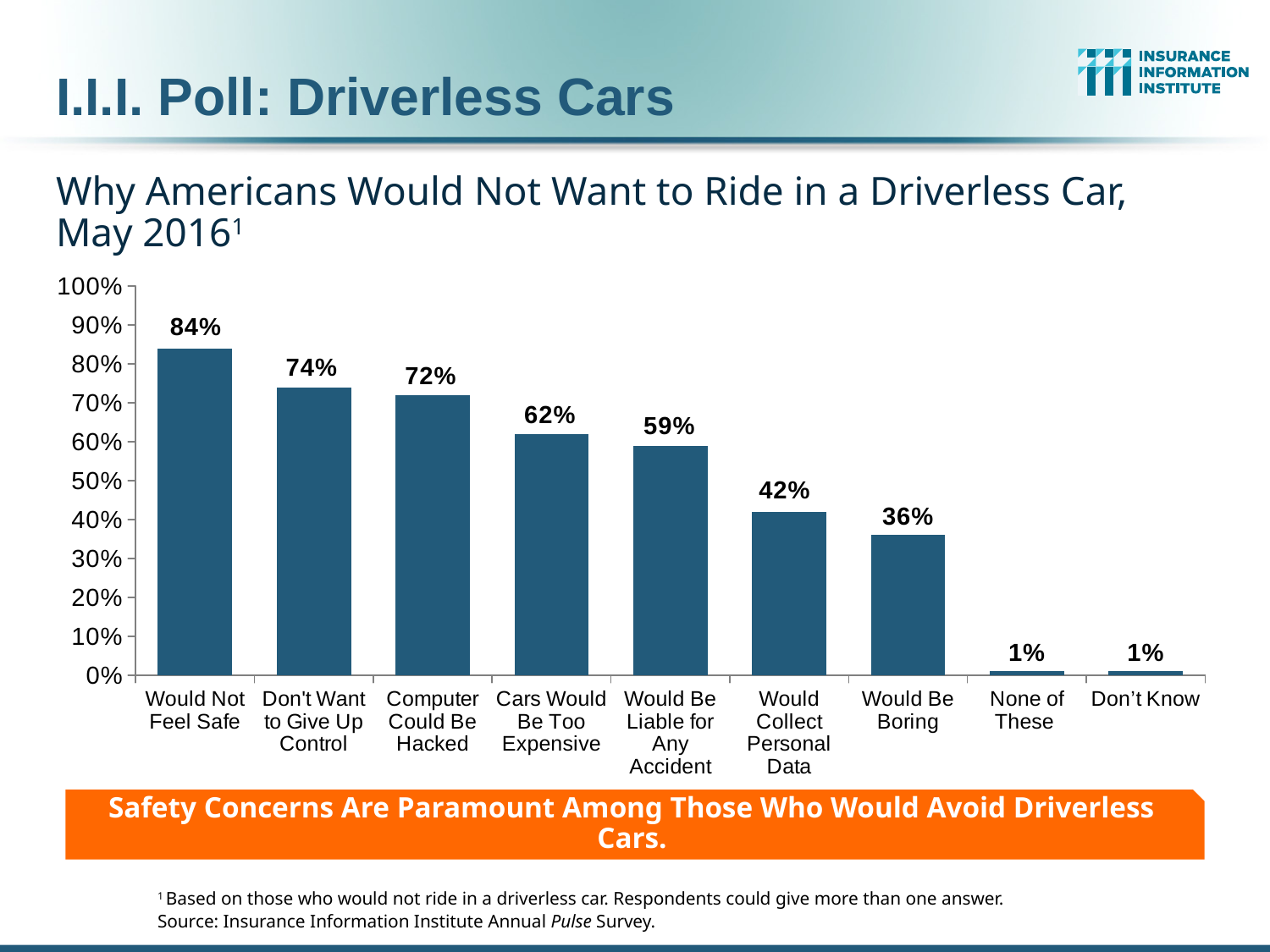
What percentage cited "Would Collect Personal Data" as a reason? 42% What is the difference between "Cars Would Be Too Expensive" and "Would Be Boring"? 26% What is the difference between "Would Not Feel Safe" and "Don't Want to Give Up Control"? 10% What kind of chart is shown on the slide? bar chart How many categories are shown on the chart? 9 What is the value for "Computer Could Be Hacked"? 72% Do the values rise or fall from left to right along the x axis? fall Is the value for "Would Be Boring" greater or less than 40%? less What is the title of the chart? Why Americans Would Not Want to Ride in a Driverless Car, May 2016 What percentage of respondents said they would not feel safe? 84% Which reason has the highest percentage? Would Not Feel Safe Which is larger, "Would Be Liable for Any Accident" or "Would Collect Personal Data"? Would Be Liable for Any Accident